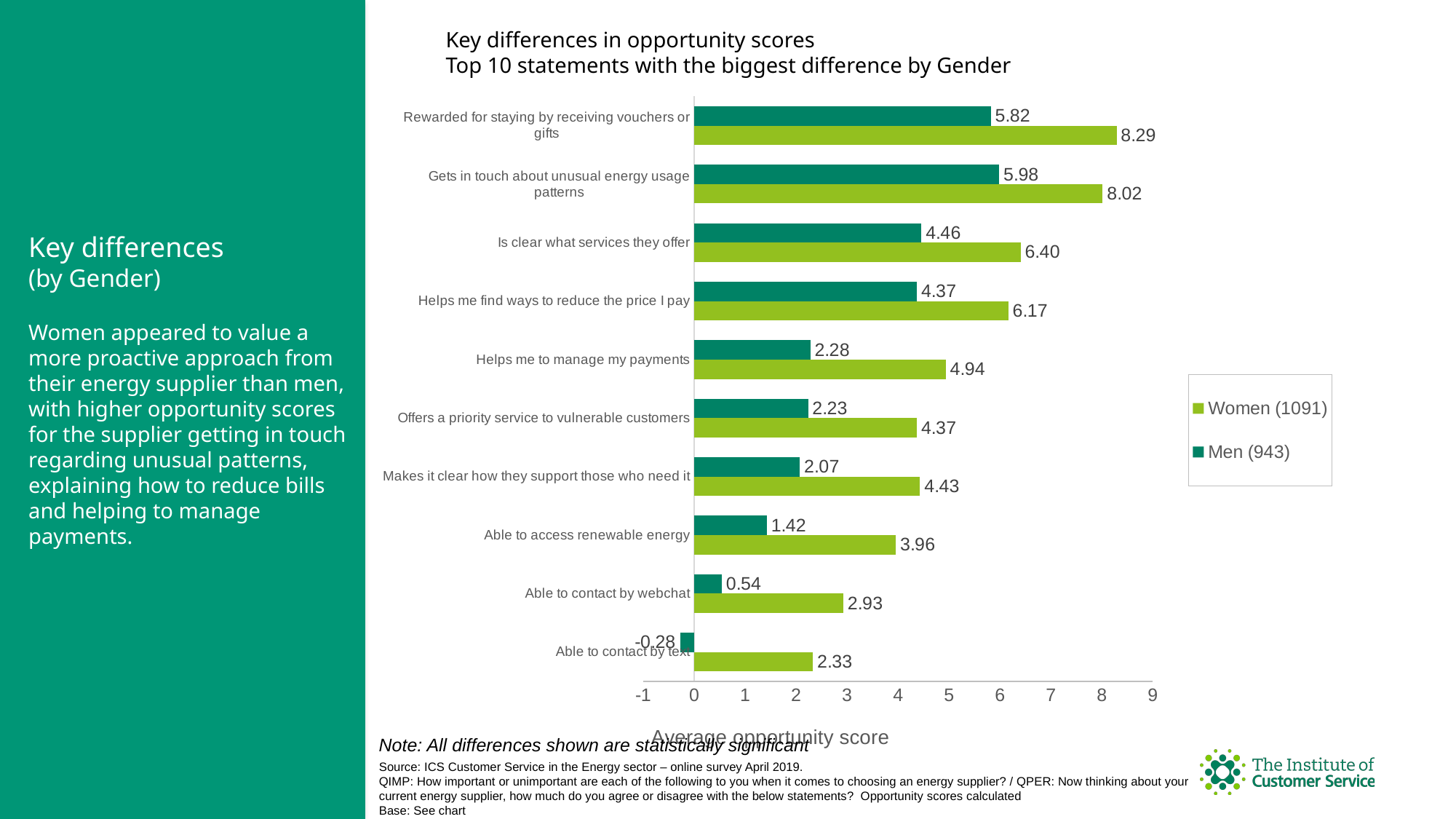
Which statement has the lowest Men (943) opportunity score? Able to contact by text What is the difference between the Women (1091) and Men (943) scores for 'Gets in touch about unusual energy usage patterns'? 2.04 How many series does the legend list? 2 What kind of chart is shown on the slide? Bar chart Which statement has the highest Women (1091) opportunity score? Rewarded for staying by receiving vouchers or gifts Is the Women (1091) score for 'Is clear what services they offer' greater or less than 6? greater What is the Men (943) opportunity score for 'Helps me to manage my payments'? 2.28 Which is larger for 'Able to access renewable energy': the Women (1091) score or the Men (943) score? Women (1091) What is the label of the horizontal axis? Average opportunity score What is the Women (1091) opportunity score for 'Rewarded for staying by receiving vouchers or gifts'? 8.29 How many statements are shown on the chart? 10 What is the Men (943) opportunity score for 'Able to contact by text'? -0.28